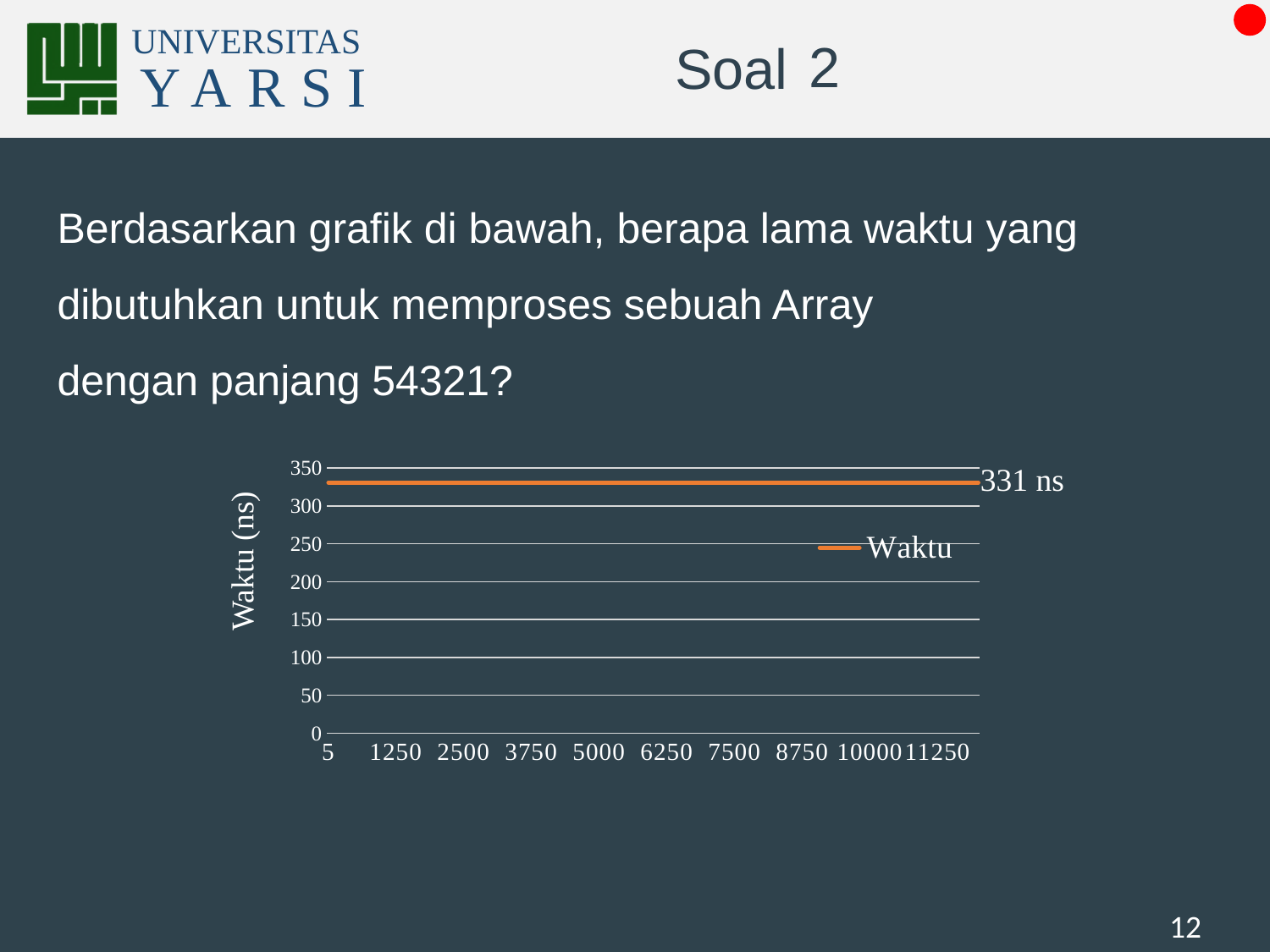
Is the value of the Waktu line greater or less than 350? less How many tick labels are shown along the x axis of the chart? 10 What is the name of the series shown in the chart legend? Waktu What is the highest value shown on the vertical axis of the chart? 350 Does the Waktu line rise, fall, or stay flat as the array length increases along the x axis? stays flat Is the value of the Waktu line greater or less than 300? greater What is the label on the vertical axis of the chart? Waktu (ns) What kind of chart is shown on the slide? line chart What value is printed as the data label at the right end of the Waktu line? 331 ns How many series does the chart legend list? 1